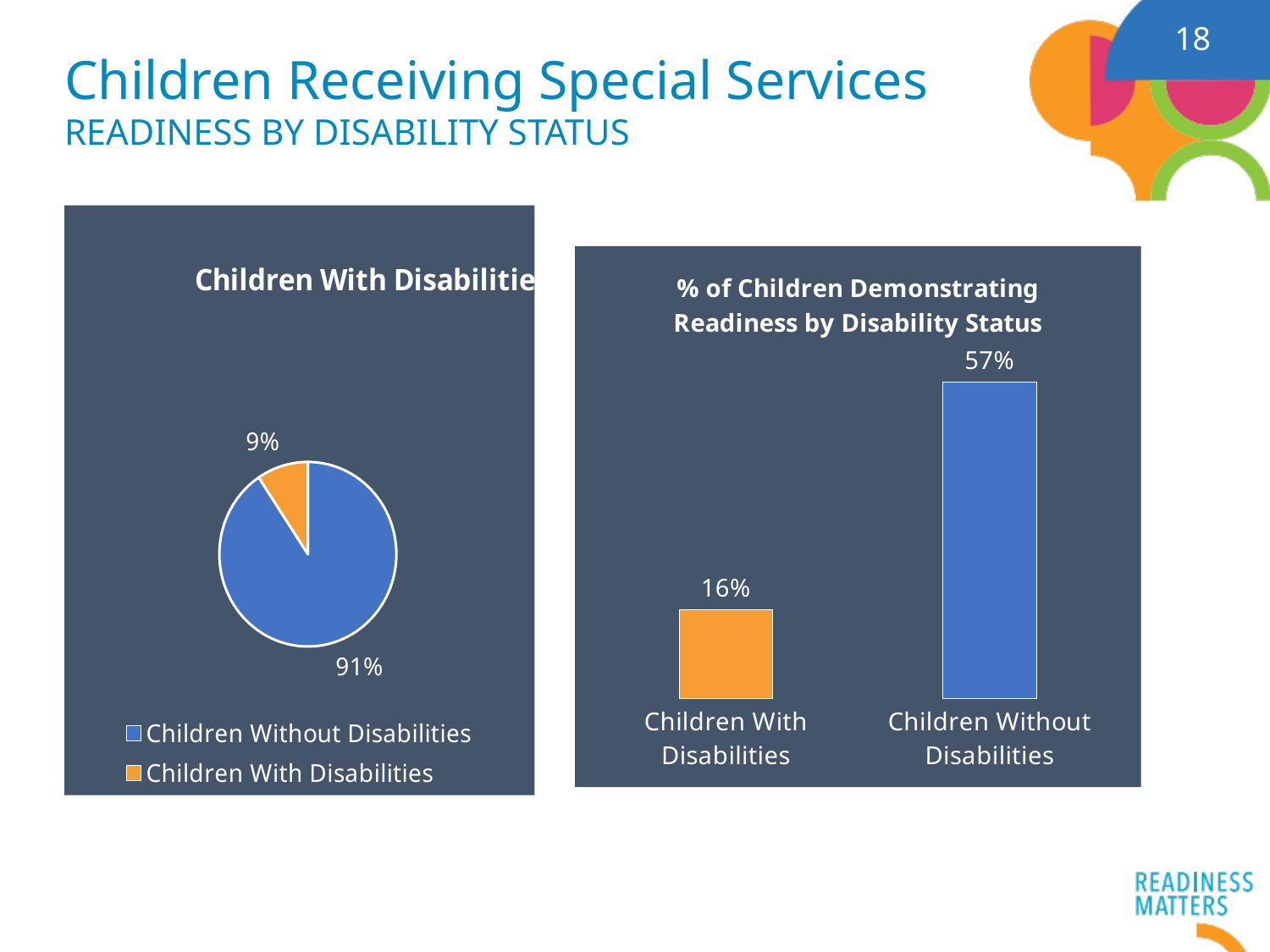
In the pie chart on the left, what share of children are Children Without Disabilities? 91% In the chart titled '% of Children Demonstrating Readiness by Disability Status', what is the difference between the values for Children Without Disabilities and Children With Disabilities? 41% In the pie chart on the left, which slice is larger, Children With Disabilities or Children Without Disabilities? Children Without Disabilities What kind of chart is the chart on the left? Pie chart In the chart titled '% of Children Demonstrating Readiness by Disability Status', what is the value for Children With Disabilities? 16% In the chart titled '% of Children Demonstrating Readiness by Disability Status', which category has the highest value? Children Without Disabilities What kind of chart is the chart on the right? Bar chart How many slices does the pie chart on the left have? 2 In the pie chart on the left, what colour is the Children With Disabilities slice? Orange In the pie chart on the left, what share of children are Children With Disabilities? 9% In the chart titled '% of Children Demonstrating Readiness by Disability Status', what is the value for Children Without Disabilities? 57% How many categories are shown in the chart titled '% of Children Demonstrating Readiness by Disability Status'? 2